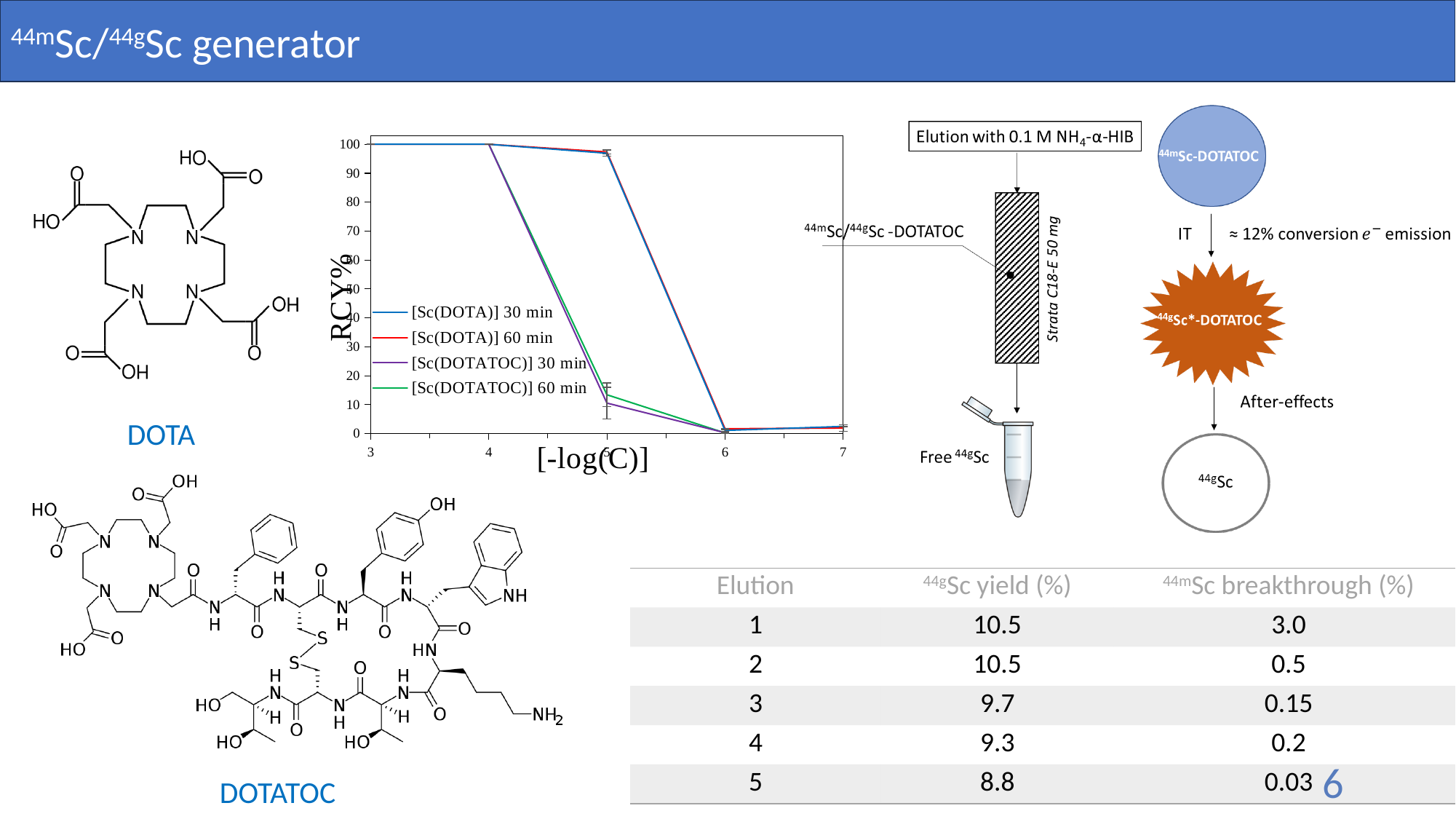
At [-log(C)] = 5, which series has the larger RCY%: [Sc(DOTA)] 60 min or [Sc(DOTATOC)] 60 min? [Sc(DOTA)] 60 min What is the label of the y axis of the chart? RCY% How many series does the chart legend list? 4 Do the RCY% values rise or fall as [-log(C)] increases from 4 to 6? fall Which colour is used for the [Sc(DOTATOC)] 60 min series in the chart? green Is the value for [Sc(DOTA)] 30 min at [-log(C)] = 5 greater or less than 90? greater Is the value for [Sc(DOTATOC)] 30 min at [-log(C)] = 5 greater or less than 20? less What is the RCY% value for [Sc(DOTA)] 30 min at [-log(C)] = 3? 100 What is the highest value shown on the y axis of the chart? 100 What kind of chart is shown on the slide? line chart How many [-log(C)] tick values are shown on the x axis of the chart? 5 Is the value for [Sc(DOTA)] 60 min at [-log(C)] = 6 greater or less than 10? less